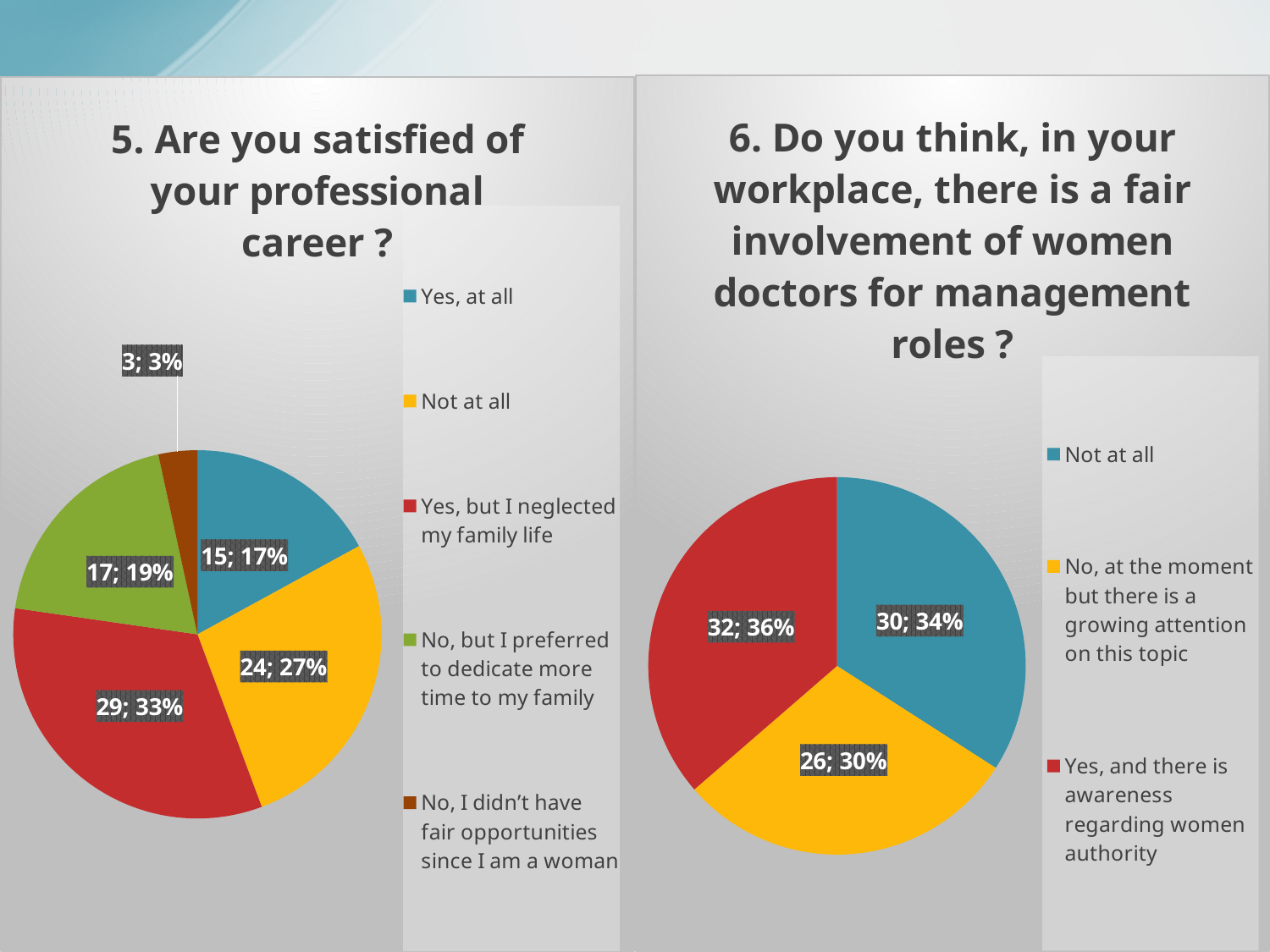
In the chart titled "5. Are you satisfied of your professional career ?", which category has the largest slice? Yes, but I neglected my family life In the chart titled "5. Are you satisfied of your professional career ?", what is the count for "Yes, but I neglected my family life"? 29 In the chart titled "5. Are you satisfied of your professional career ?", how many categories does the legend list? 5 In the chart titled "6. Do you think, in your workplace, there is a fair involvement of women doctors for management roles ?", what is the count for "Not at all"? 30 In the chart titled "5. Are you satisfied of your professional career ?", what colour is the "No, but I preferred to dedicate more time to my family" slice? Green In the chart titled "6. Do you think, in your workplace, there is a fair involvement of women doctors for management roles ?", how many categories does the legend list? 3 In the chart titled "5. Are you satisfied of your professional career ?", what kind of chart is shown? Pie chart In the chart titled "5. Are you satisfied of your professional career ?", what percentage share does "Not at all" have? 27% In the chart titled "5. Are you satisfied of your professional career ?", what is the difference in count between "Not at all" and "Yes, at all"? 9 In the chart titled "6. Do you think, in your workplace, there is a fair involvement of women doctors for management roles ?", which category has the largest slice? Yes, and there is awareness regarding women authority In the chart titled "5. Are you satisfied of your professional career ?", which category has the smallest slice? No, I didn't have fair opportunities since I am a woman In the chart titled "6. Do you think, in your workplace, there is a fair involvement of women doctors for management roles ?", what percentage share does "No, at the moment but there is a growing attention on this topic" have? 30%